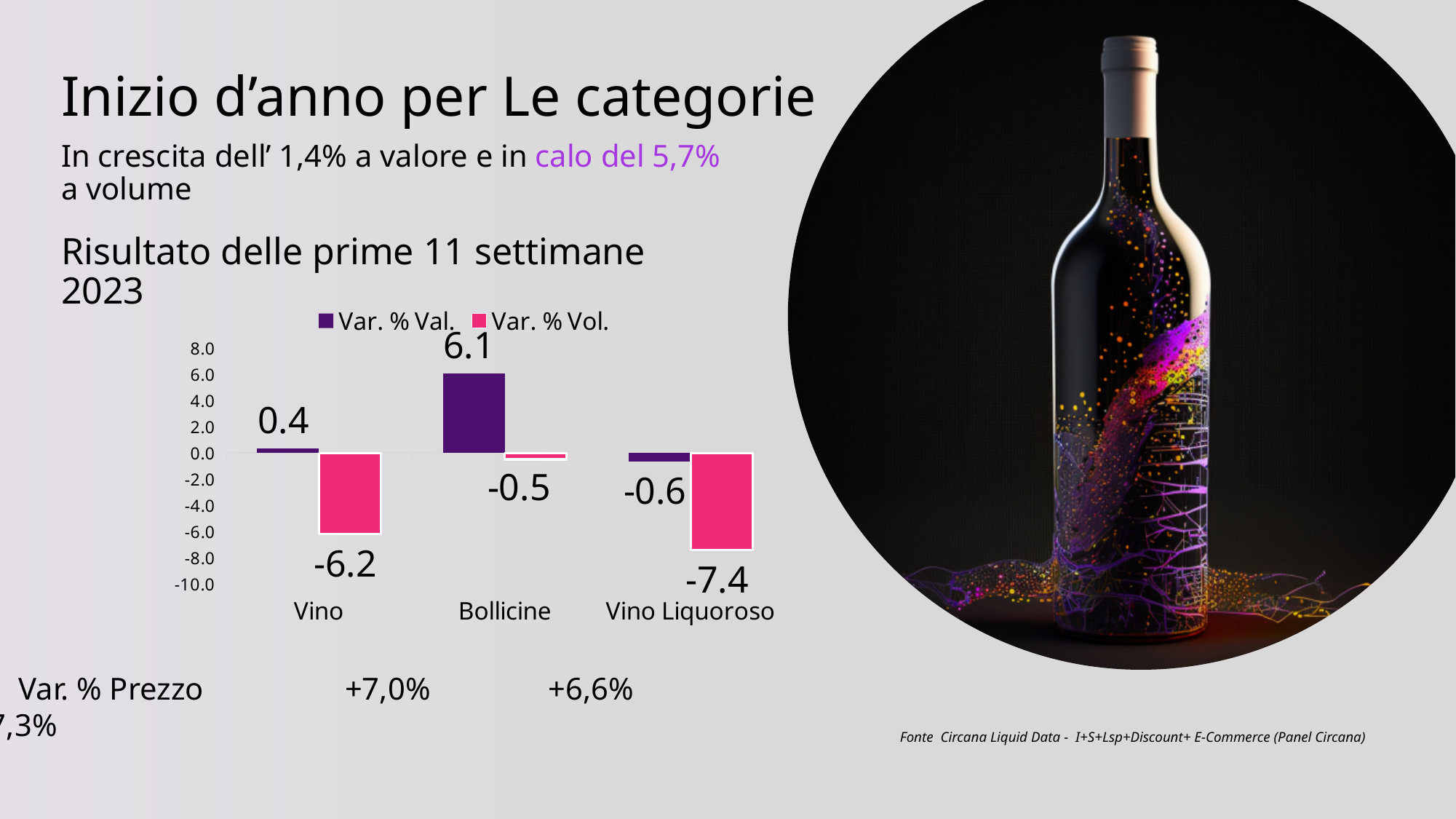
What is the Var. % Val. value for Bollicine? 6.1 How many series does the chart legend list? 2 Which category has the highest Var. % Val. value? Bollicine What kind of chart is shown on the slide? Bar chart What is the Var. % Vol. value for Bollicine? -0.5 What is the Var. % Val. value for Vino? 0.4 What is the Var. % Vol. value for Vino Liquoroso? -7.4 Which is larger, the Var. % Vol. value for Vino or for Bollicine? Bollicine What is the Var. % Vol. value for Vino? -6.2 Which category has the lowest Var. % Vol. value? Vino Liquoroso How many categories are shown on the x axis of the chart? 3 What is the difference between the Var. % Val. and Var. % Vol. values for Bollicine? 6.6